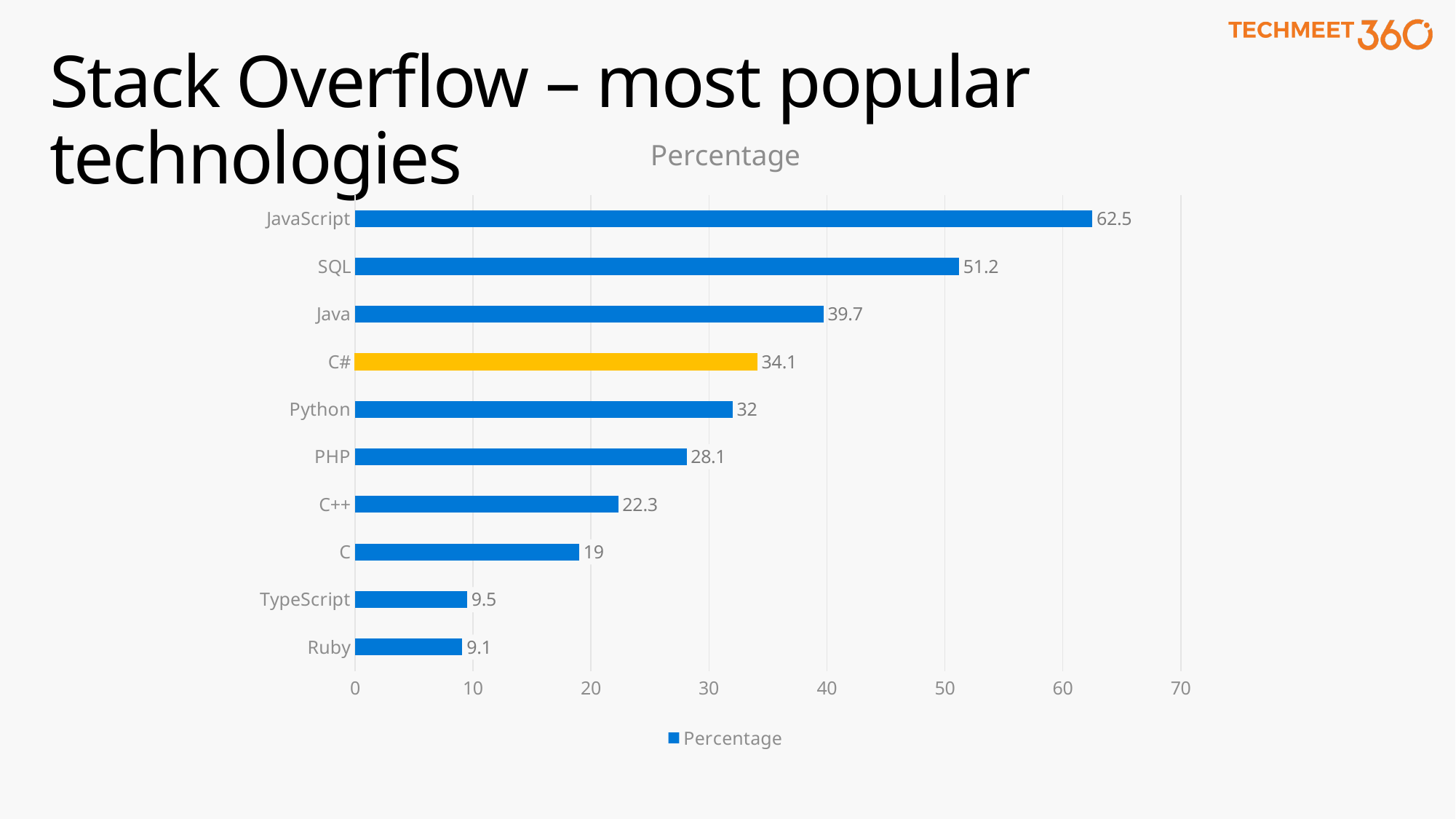
What is the value for JavaScript? 62.5 What is the value for C#? 34.1 Which has a larger value, Java or C#? Java Which technology has the lowest value? Ruby Is the value for C++ greater or less than 20? greater What is the value for TypeScript? 9.5 How many technologies are shown in the chart? 10 What is the difference between the values for JavaScript and SQL? 11.3 Which technology has the highest value? JavaScript What is the difference between the values for Python and PHP? 3.9 What kind of chart is shown on the slide? bar chart Which bar is highlighted in a different colour (yellow) from the others? C#